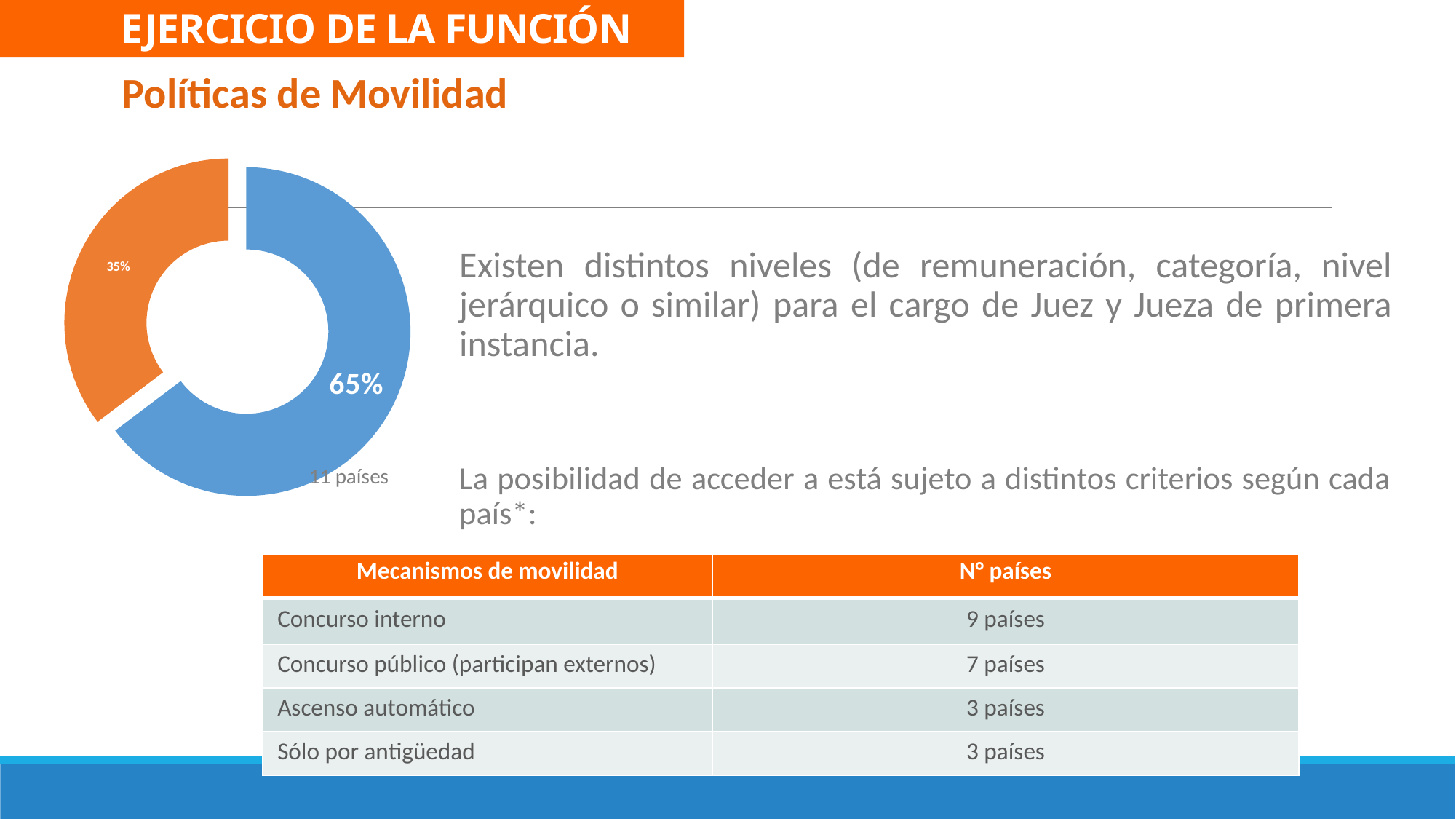
How many slices does the doughnut chart have? 2 What do the two slices of the doughnut chart add up to? 100% What percentage is shown on the orange slice of the doughnut chart? 35% By how many percentage points does the blue slice exceed the orange slice in the doughnut chart? 30 percentage points What two colours are used for the slices of the doughnut chart? blue and orange What percentage is shown on the blue slice of the doughnut chart? 65% What kind of chart is shown on the left of the slide? doughnut chart What text label appears just below the blue slice of the doughnut chart? 11 países Which slice of the doughnut chart is the largest? the blue slice (65%) Which slice of the doughnut chart is the smallest? the orange slice (35%) Is the blue slice or the orange slice of the doughnut chart larger? the blue slice